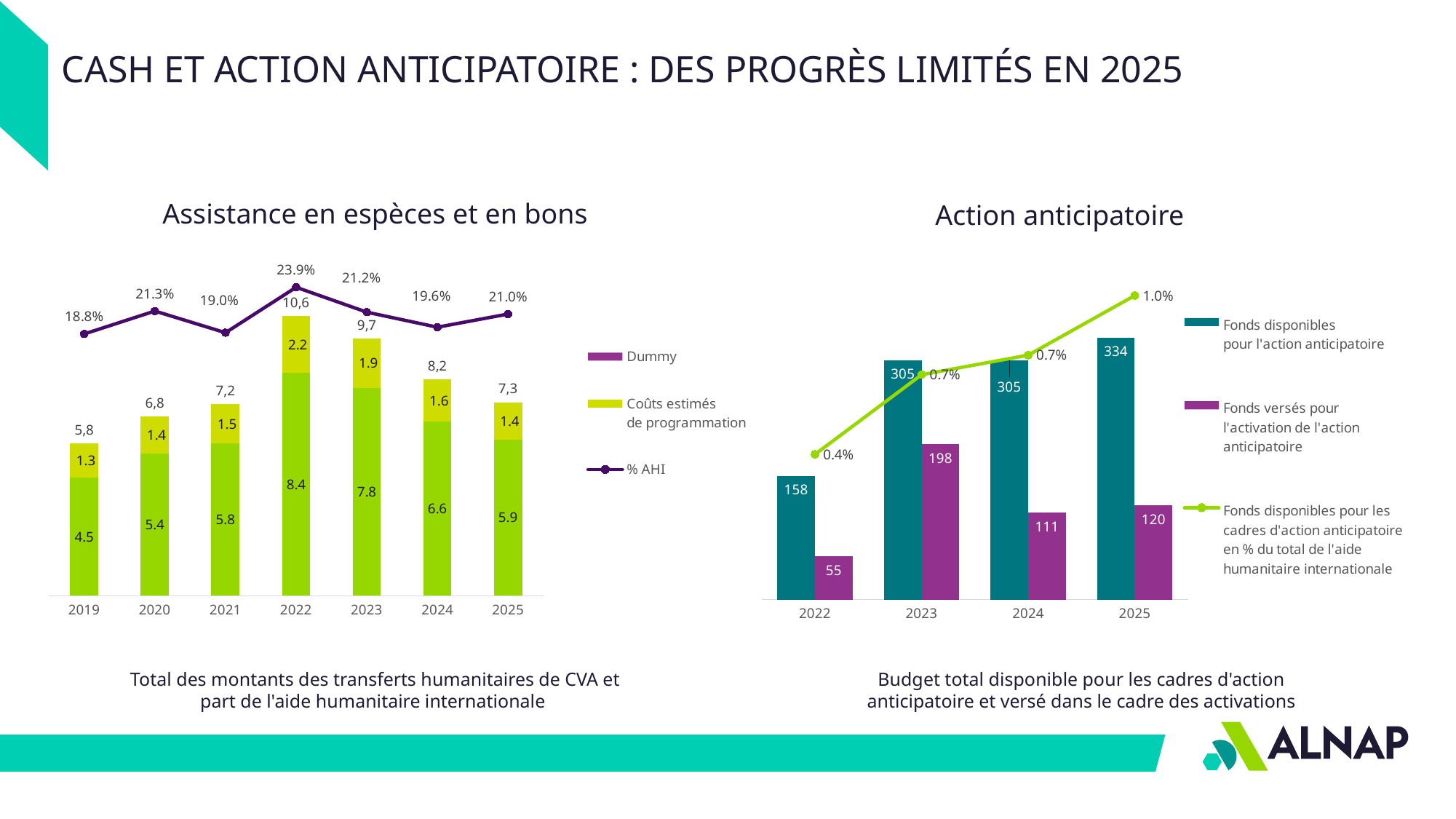
On the 'Assistance en espèces et en bons' chart, which year has the highest stacked bar total? 2022 On the 'Action anticipatoire' chart, what is the difference between the 'Fonds disponibles pour l'action anticipatoire' values for 2025 and 2022? 176 On the 'Action anticipatoire' chart, does the line series rise or fall from 2022 to 2025? rise On the 'Assistance en espèces et en bons' chart, what is the 'Coûts estimés de programmation' value for 2020? 1.4 On the 'Action anticipatoire' chart, which year has the lowest 'Fonds versés pour l'activation de l'action anticipatoire' value? 2022 On the 'Action anticipatoire' chart, what is the 'Fonds versés pour l'activation de l'action anticipatoire' value for 2023? 198 On the 'Assistance en espèces et en bons' chart, how many years are shown on the x axis? 7 On the 'Assistance en espèces et en bons' chart, what is the total of the stacked bar for 2023? 9,7 On the 'Action anticipatoire' chart, what is the 'Fonds disponibles pour l'action anticipatoire' value for 2025? 334 On the 'Assistance en espèces et en bons' chart, which year has the lowest % AHI value? 2019 On the 'Assistance en espèces et en bons' chart, what is the difference between the 'Coûts estimés de programmation' values for 2022 and 2025? 0.8 On the 'Assistance en espèces et en bons' chart, what is the % AHI value for 2022? 23.9%